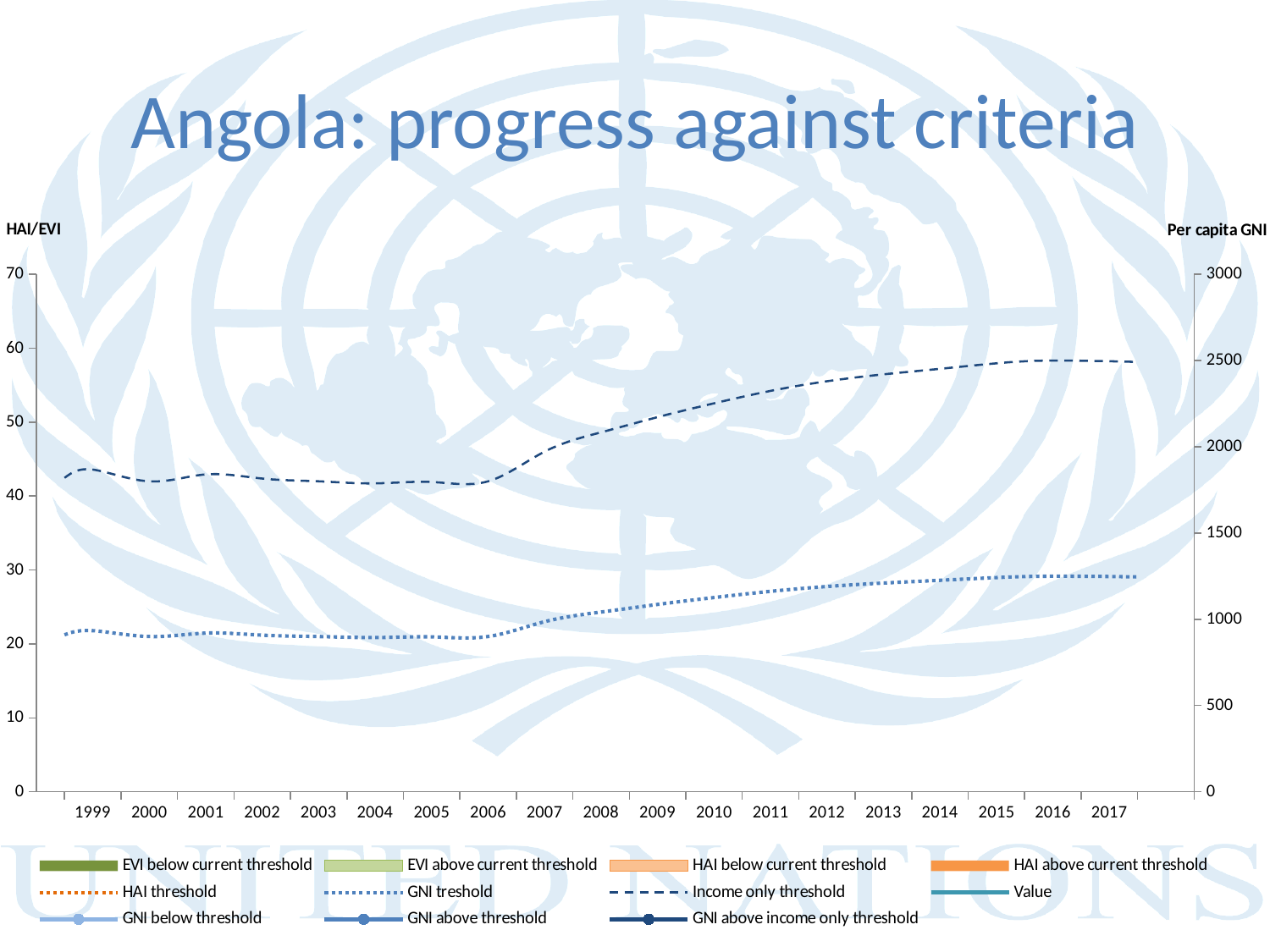
In 2017, which line is higher: the dashed 'Income only threshold' line or the dotted 'GNI treshold' line? Income only threshold What kind of chart is shown on the slide? line chart Does the dotted 'GNI treshold' line rise or fall overall from 1999 to 2017? rise On the right-hand Per capita GNI axis, is the dotted 'GNI treshold' line in 2006 greater or less than 1000? less What is the title of the chart on the slide? Angola: progress against criteria What is the label of the right-hand vertical axis? Per capita GNI On the right-hand Per capita GNI axis, is the dashed 'Income only threshold' line in 1999 greater or less than 2000? less On the right-hand Per capita GNI axis, is the dotted 'GNI treshold' line in 2017 greater or less than 1000? greater Does the dashed 'Income only threshold' line rise or fall overall from 1999 to 2017? rise How many years are labelled along the x axis of the chart? 19 How many entries does the chart's legend list? 11